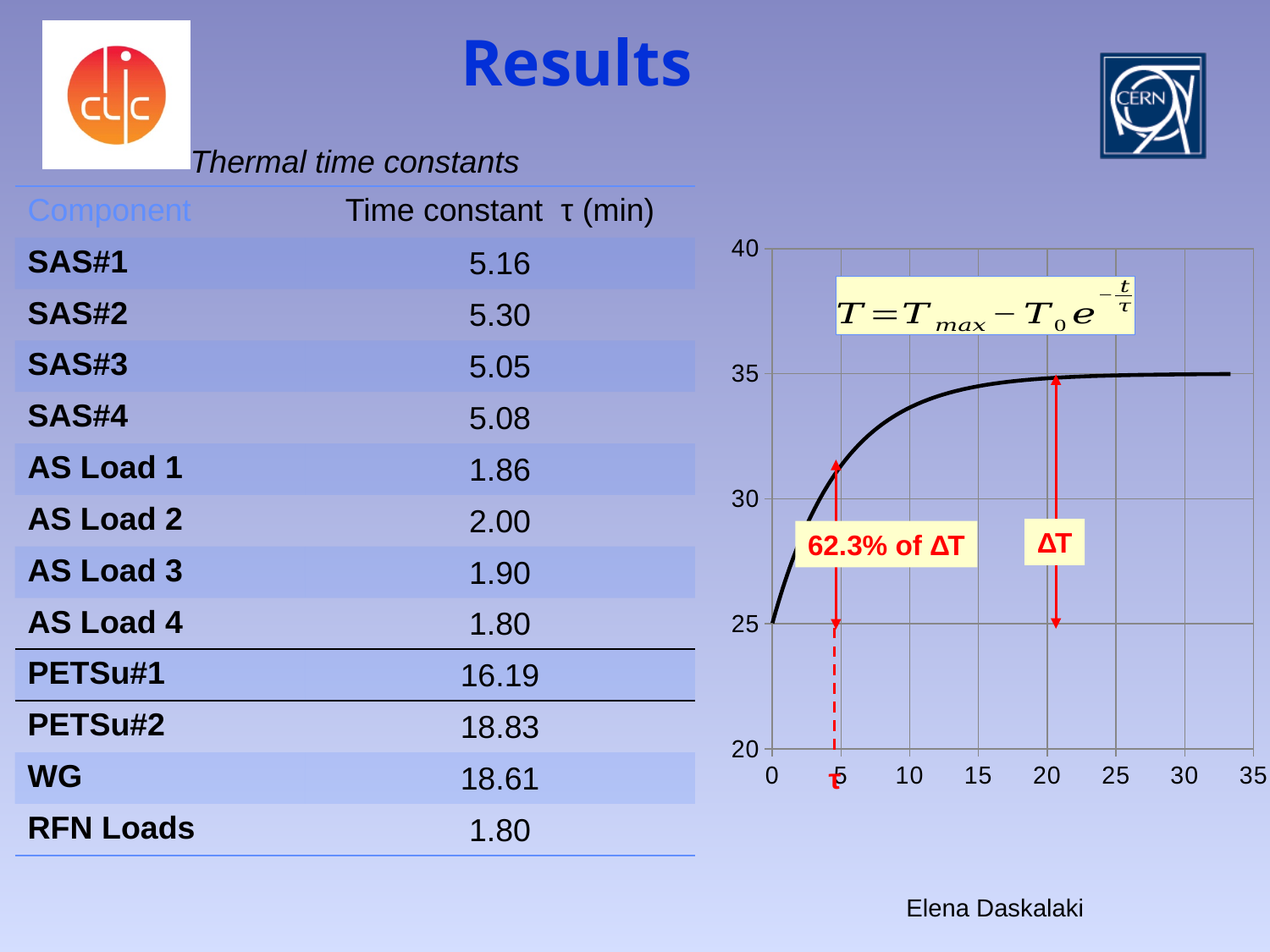
Does the curve in the chart rise or fall as the x-axis value increases? rises Is the value of the curve at x = 2 greater or less than 30? less What is the highest tick value shown on the y-axis of the chart? 40 At what value does the curve level off at the right side of the chart? 35 How many lines (series) are plotted in the chart? 1 What is the value of the curve at x = 0? 25 Which is larger, the value of the curve at x = 5 or at x = 20? x = 20 What kind of chart is shown on the right of the slide? line chart Is the value of the curve at x = 5 greater or less than 30? greater Is the value of the curve at x = 10 greater or less than 35? less What does the red annotation on the left arrow in the chart say? 62.3% of ΔT